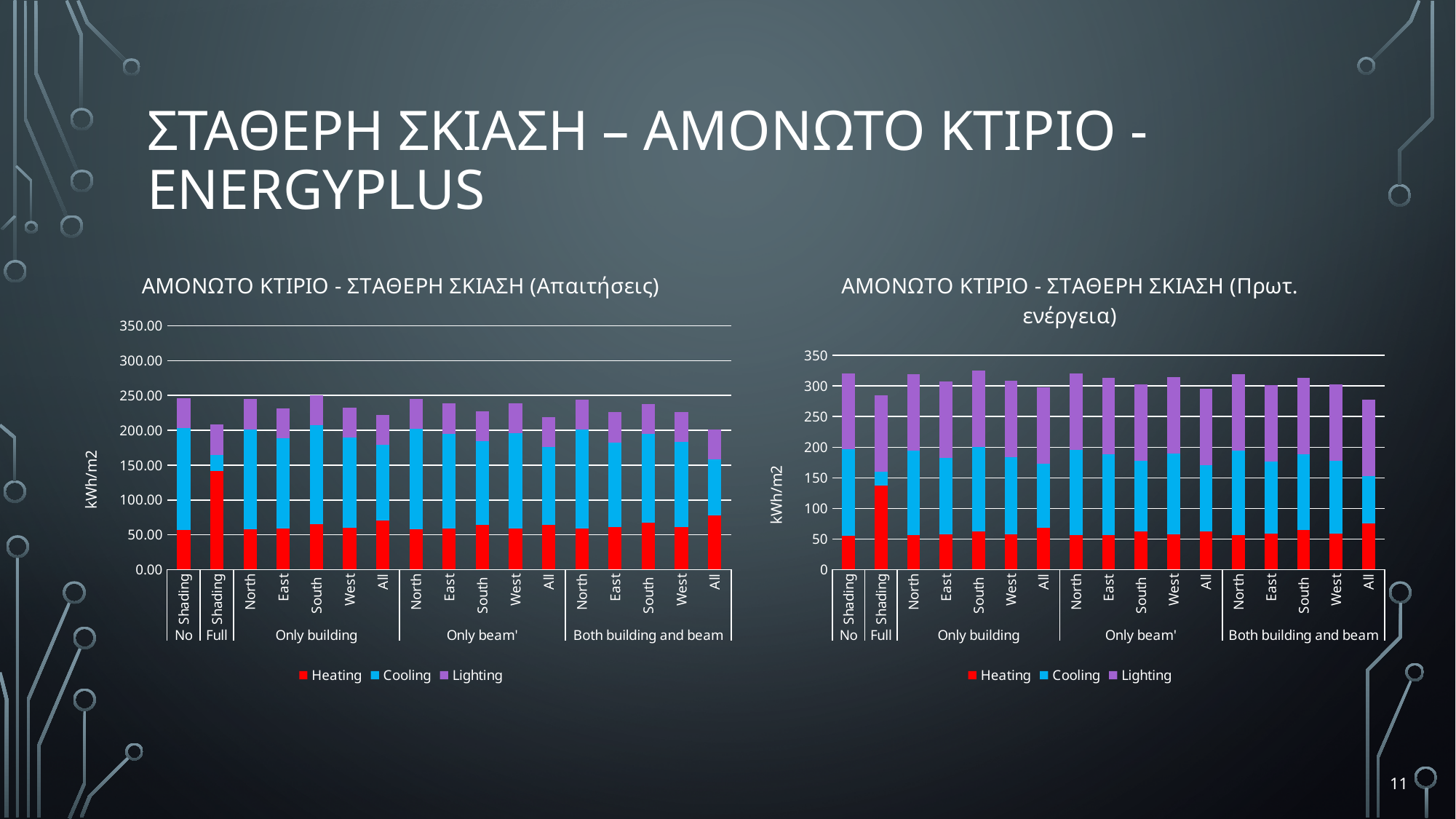
What kind of chart is the left chart, 'ΑΜΟΝΩΤΟ ΚΤΙΡΙΟ - ΣΤΑΘΕΡΗ ΣΚΙΑΣΗ (Απαιτήσεις)'? Stacked bar chart How many series does the legend of the right chart, 'ΑΜΟΝΩΤΟ ΚΤΙΡΙΟ - ΣΤΑΘΕΡΗ ΣΚΙΑΣΗ (Πρωτ. ενέργεια)', list? 3 In the left chart (Απαιτήσεις), which has the larger Heating value: No Shading or Full Shading? Full Shading In the left chart (Απαιτήσεις), how many bars are plotted in total? 17 What is the y-axis label of the left chart (Απαιτήσεις)? kWh/m2 In the left chart (Απαιτήσεις), is the Heating value for Full Shading greater or less than 100.00? greater In the left chart (Απαιτήσεις), is the total for Full Shading greater or less than 250.00? less In the right chart (Πρωτ. ενέργεια), is the total for 'All' under 'Both building and beam' greater or less than 300? less In the right chart (Πρωτ. ενέργεια), which has the larger total: No Shading or Full Shading? No Shading Which series is shown in red in the right chart (Πρωτ. ενέργεια)? Heating